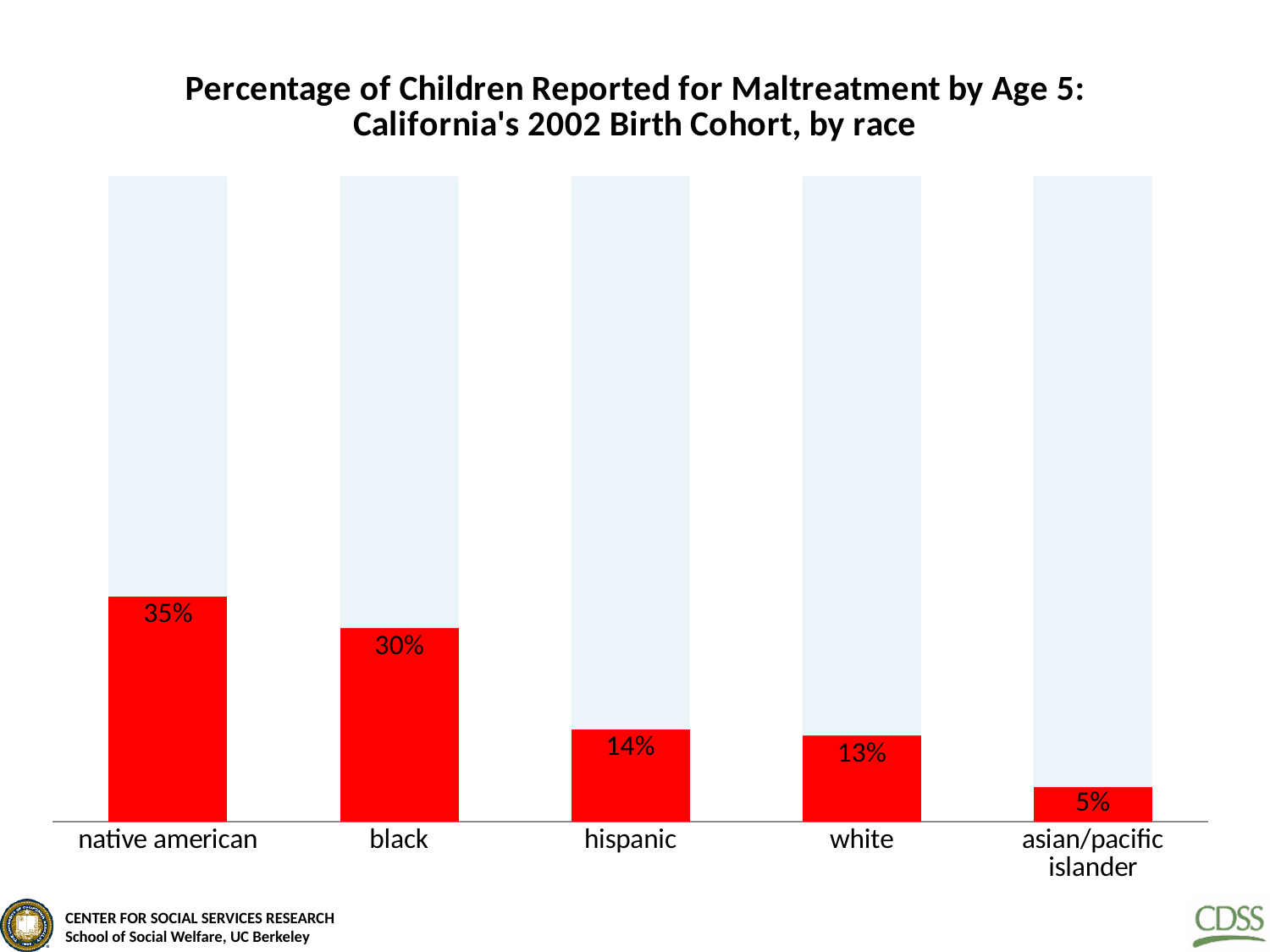
What is the value shown for hispanic children? 14% Which race category has the highest percentage of children reported for maltreatment? native american What is the value shown for black children? 30% Which is larger, the value for native american or the value for hispanic? native american What is the difference between the percentages for black and asian/pacific islander children? 25% What is the value shown for white children? 13% What kind of chart is shown on the slide? bar chart What percentage of native american children were reported for maltreatment by age 5? 35% Which race category has the lowest percentage of children reported for maltreatment? asian/pacific islander How many race categories are shown on the chart? 5 What is the value shown for asian/pacific islander children? 5% What is the difference between the percentages for native american and black children? 5%